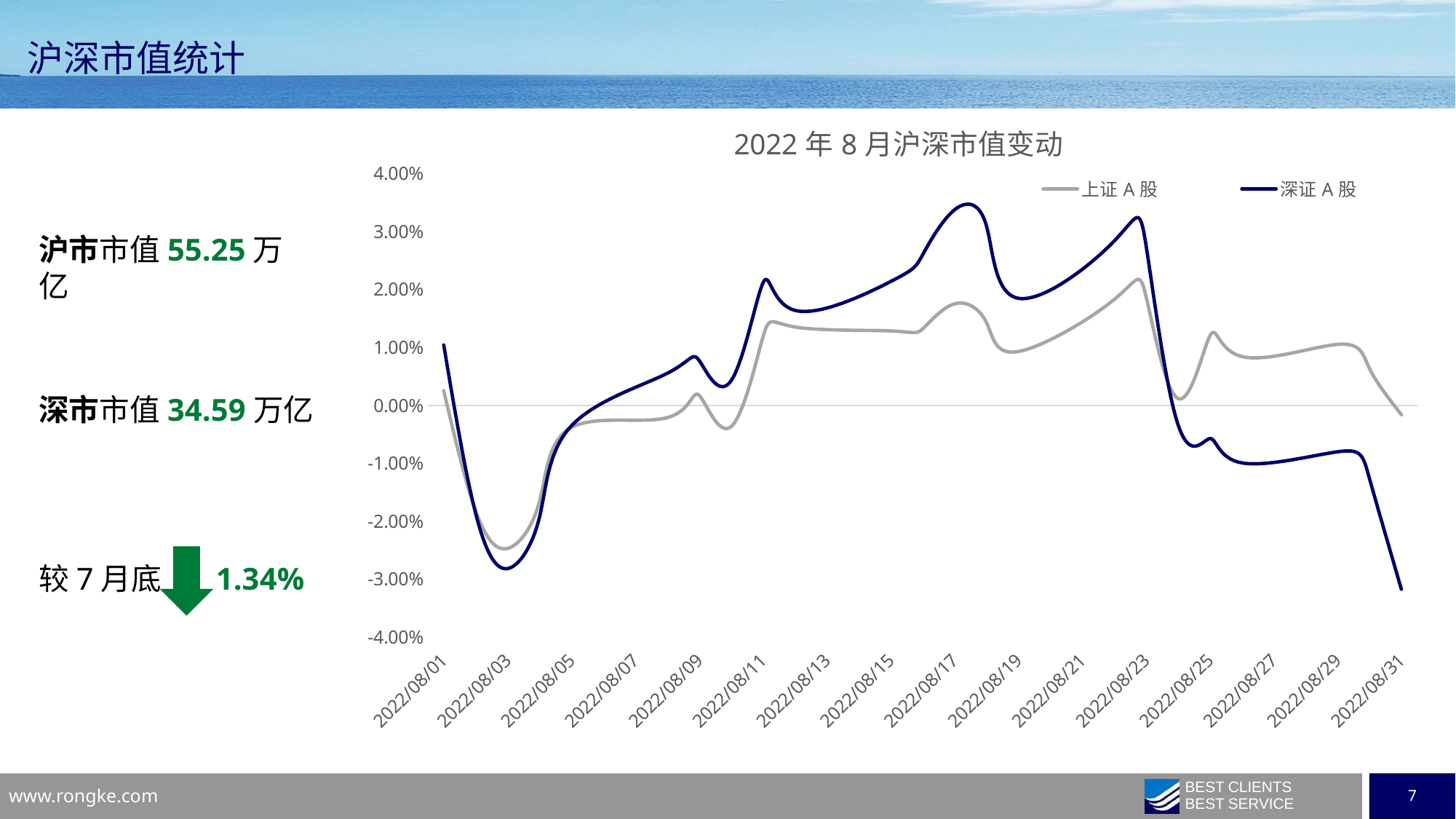
Does the 深证A股 line rise or fall between 2022/08/23 and 2022/08/31? fall How many series does the chart legend list? 2 Is the value for 深证A股 on 2022/08/17 greater or less than 3.00%? greater How many date labels are shown on the x axis of the chart? 16 Is the value for 深证A股 on 2022/08/31 greater or less than -2.00%? less What is the title of the chart? 2022年8月沪深市值变动 Is the value for 上证A股 on 2022/08/29 greater or less than 0.00%? greater Which series is drawn in dark blue in the chart? 深证A股 On 2022/08/17, which series has the higher value, 上证A股 or 深证A股? 深证A股 What kind of chart is shown on the slide? line chart On 2022/08/31, which series has the higher value, 上证A股 or 深证A股? 上证A股